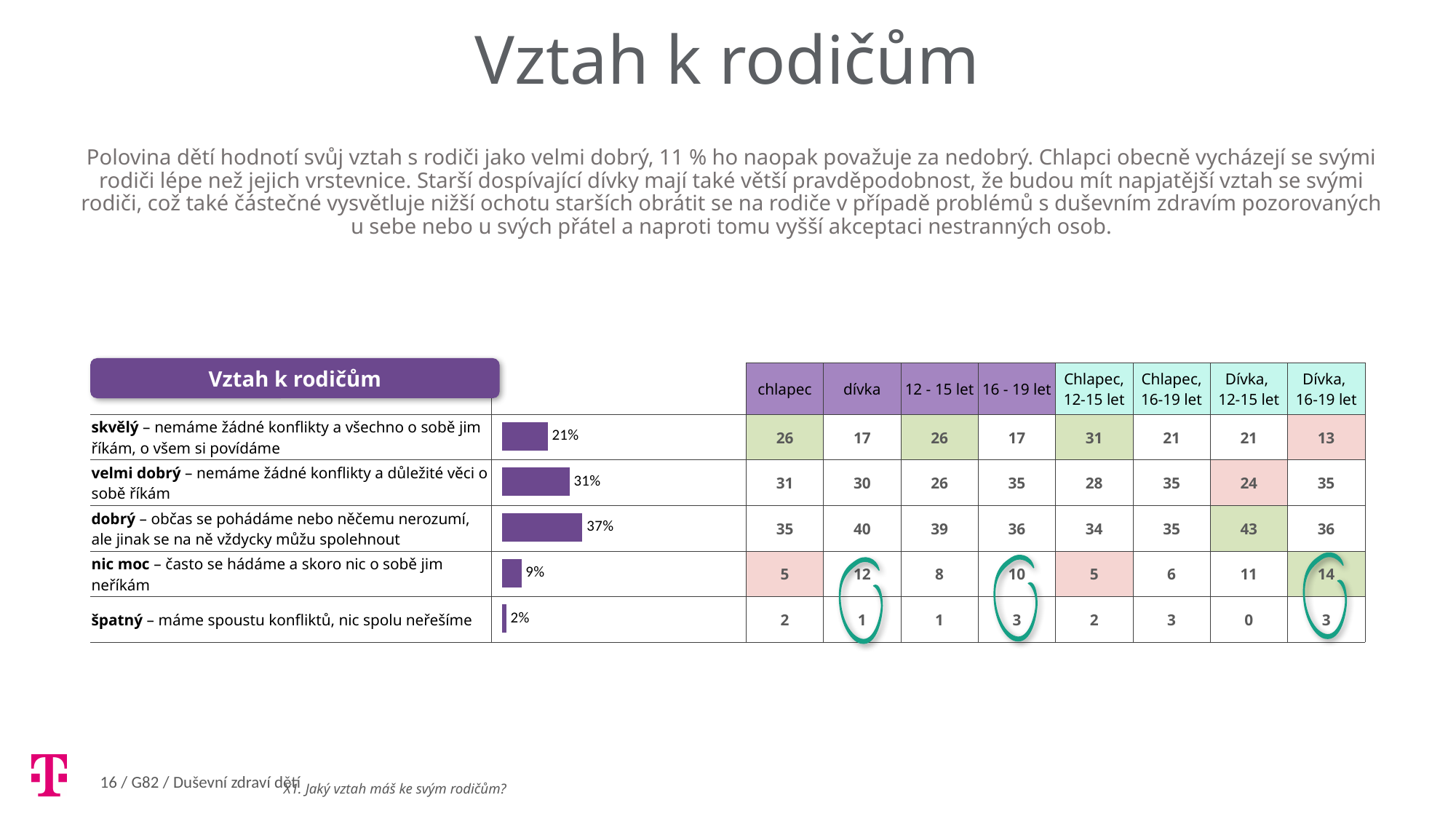
What colour are the bars in the bar chart? purple What is the difference between the values for "dobrý" and "velmi dobrý" in the bar chart? 6% How many categories does the bar chart show? 5 Which category has the highest value in the bar chart? dobrý What is the value shown for the category "dobrý" in the bar chart? 37% What is the value shown for the category "nic moc" in the bar chart? 9% Which has the larger value in the bar chart, "skvělý" or "velmi dobrý"? velmi dobrý Which category has the lowest value in the bar chart? špatný What is the value shown for the category "skvělý" in the bar chart? 21% What is the value shown for the category "špatný" in the bar chart? 2% What is the combined value of "nic moc" and "špatný" in the bar chart? 11% What kind of chart is shown on the slide under the heading "Vztah k rodičům"? bar chart